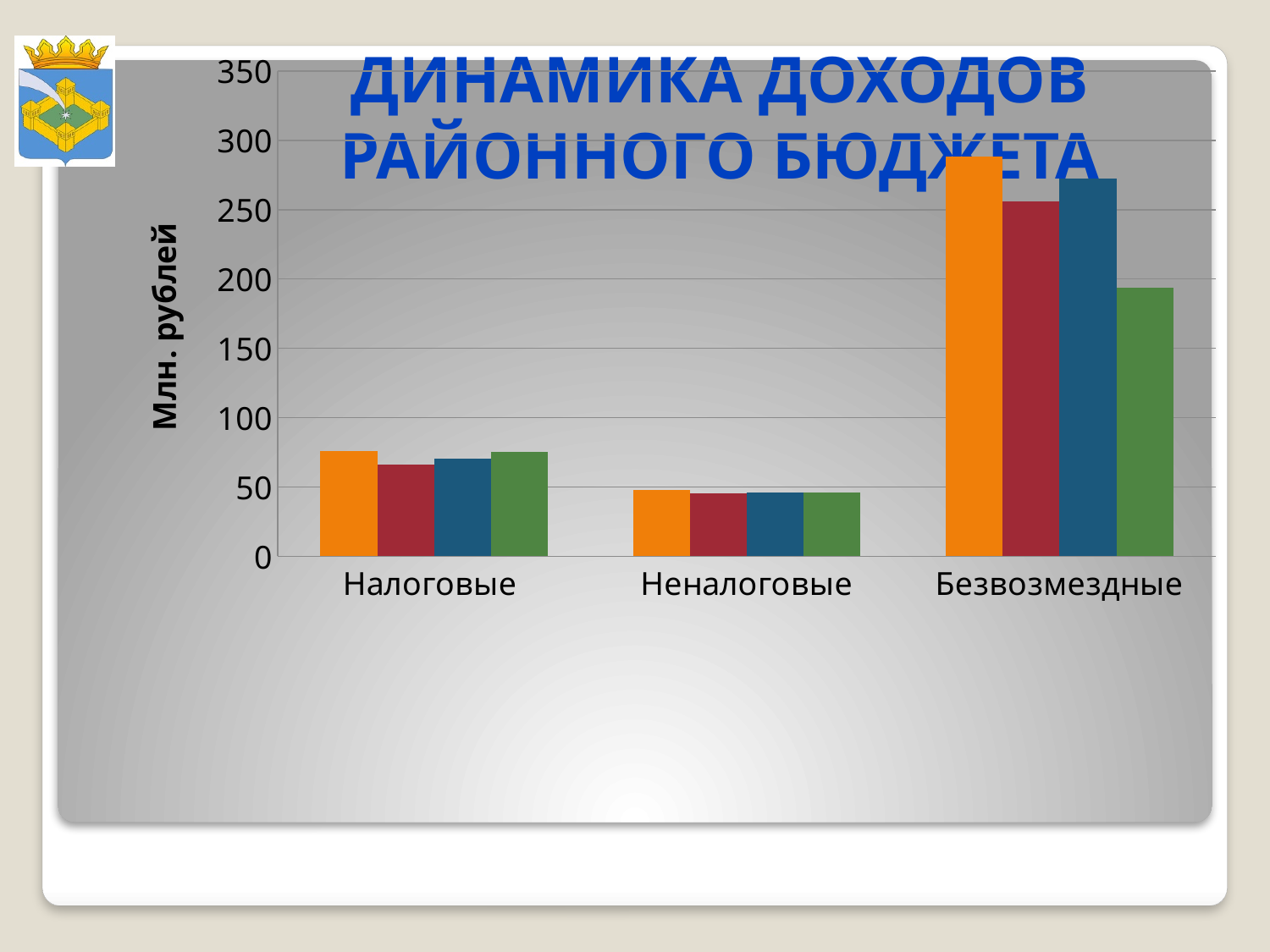
Is the value of the orange bar for Безвозмездные greater or less than 250? greater Within the Безвозмездные category, which bar is larger: the orange bar or the green bar? The orange bar How many categories are shown on the x axis? 3 How many bars are shown for each category? 4 What is the title of the chart? ДИНАМИКА ДОХОДОВ РАЙОННОГО БЮДЖЕТА What is the label of the vertical axis? Млн. рублей Which category has the highest bars? Безвозмездные Which category has the lowest bars? Неналоговые Is the value of the green bar for Безвозмездные greater or less than 200? less Is the value of the orange bar for Налоговые greater or less than 100? less What kind of chart is shown on the slide? Bar chart